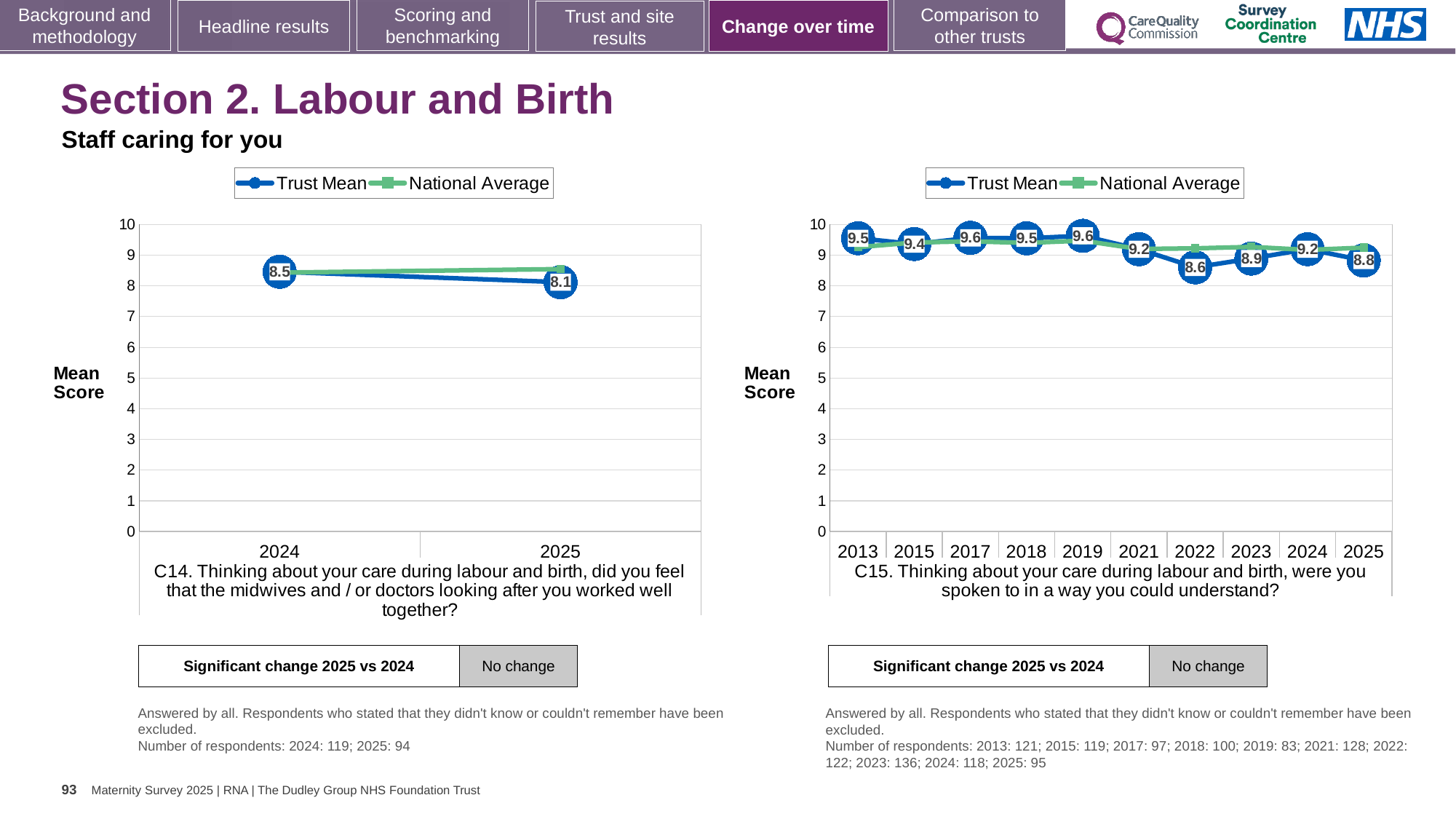
In the right chart (C15), is the Trust Mean for 2024 or 2025 larger? 2024 How many series does the legend of the left chart list? 2 In the left chart (C14), what is the Trust Mean for 2024? 8.5 In the left chart (C14), does the Trust Mean rise or fall from 2024 to 2025? fall In the left chart (C14), by how much did the Trust Mean fall from 2024 to 2025? 0.4 In the right chart (C15), how many years are shown on the x axis? 10 In the right chart (C15), what is the difference between the Trust Mean in 2019 and in 2022? 1.0 In the right chart (C15), which year has the lowest Trust Mean? 2022 In the left chart (C14), what is the Trust Mean for 2025? 8.1 What type of chart is the right chart (C15)? line chart In the right chart (C15), what is the Trust Mean for 2022? 8.6 In the right chart (C15), what is the Trust Mean for 2025? 8.8